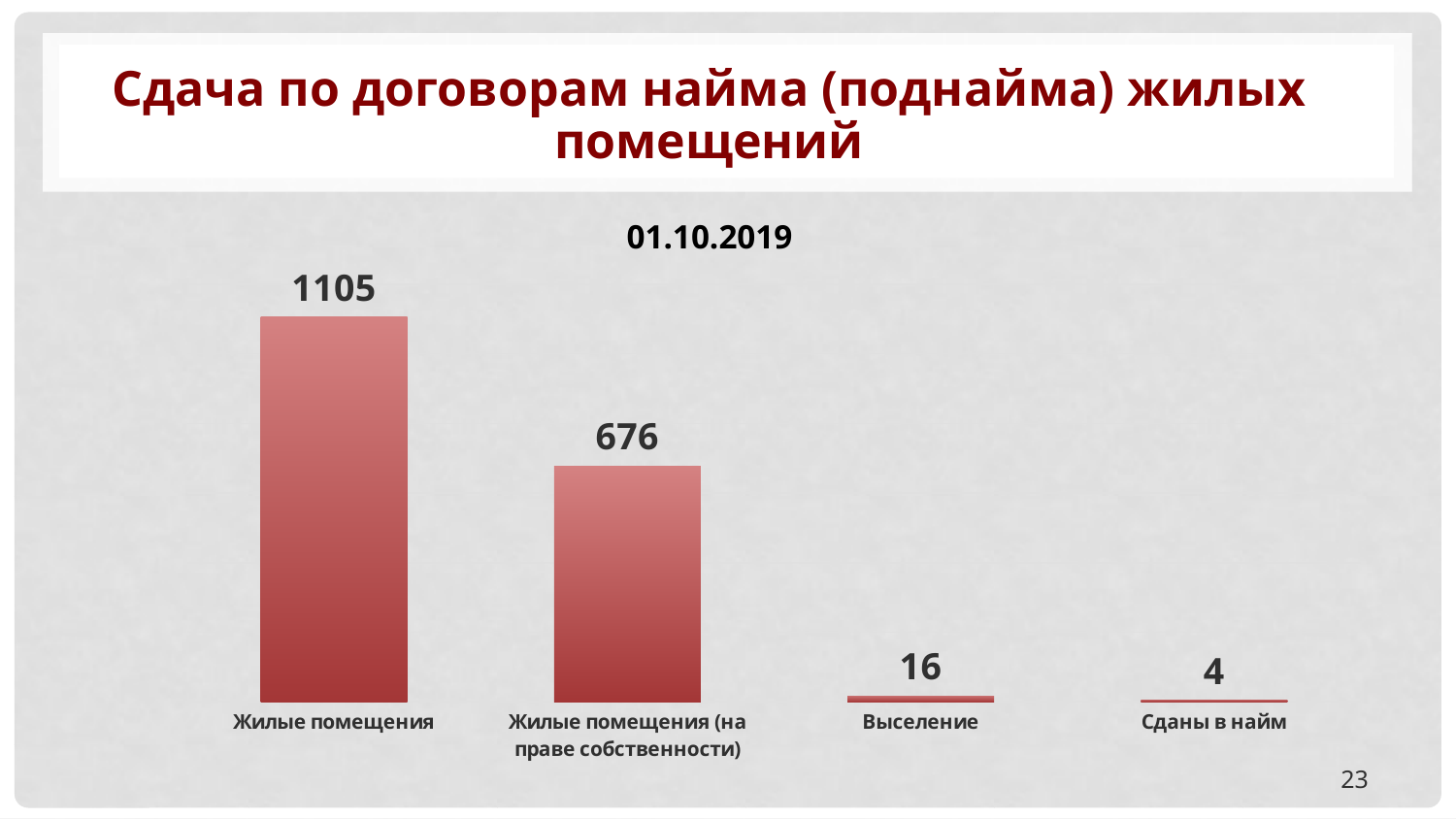
How many categories are shown in the chart? 4 Which category has the highest value? Жилые помещения What is the value for Сданы в найм? 4 What is the value for Выселение? 16 What is the value for Жилые помещения? 1105 What kind of chart is shown on the slide? Bar chart Which category has the lowest value? Сданы в найм Which is larger, the value for Выселение or the value for Сданы в найм? Выселение What is the difference between the values for Выселение and Сданы в найм? 12 What is the title of the chart? 01.10.2019 What is the difference between the values for Жилые помещения and Жилые помещения (на праве собственности)? 429 What is the value for Жилые помещения (на праве собственности)? 676